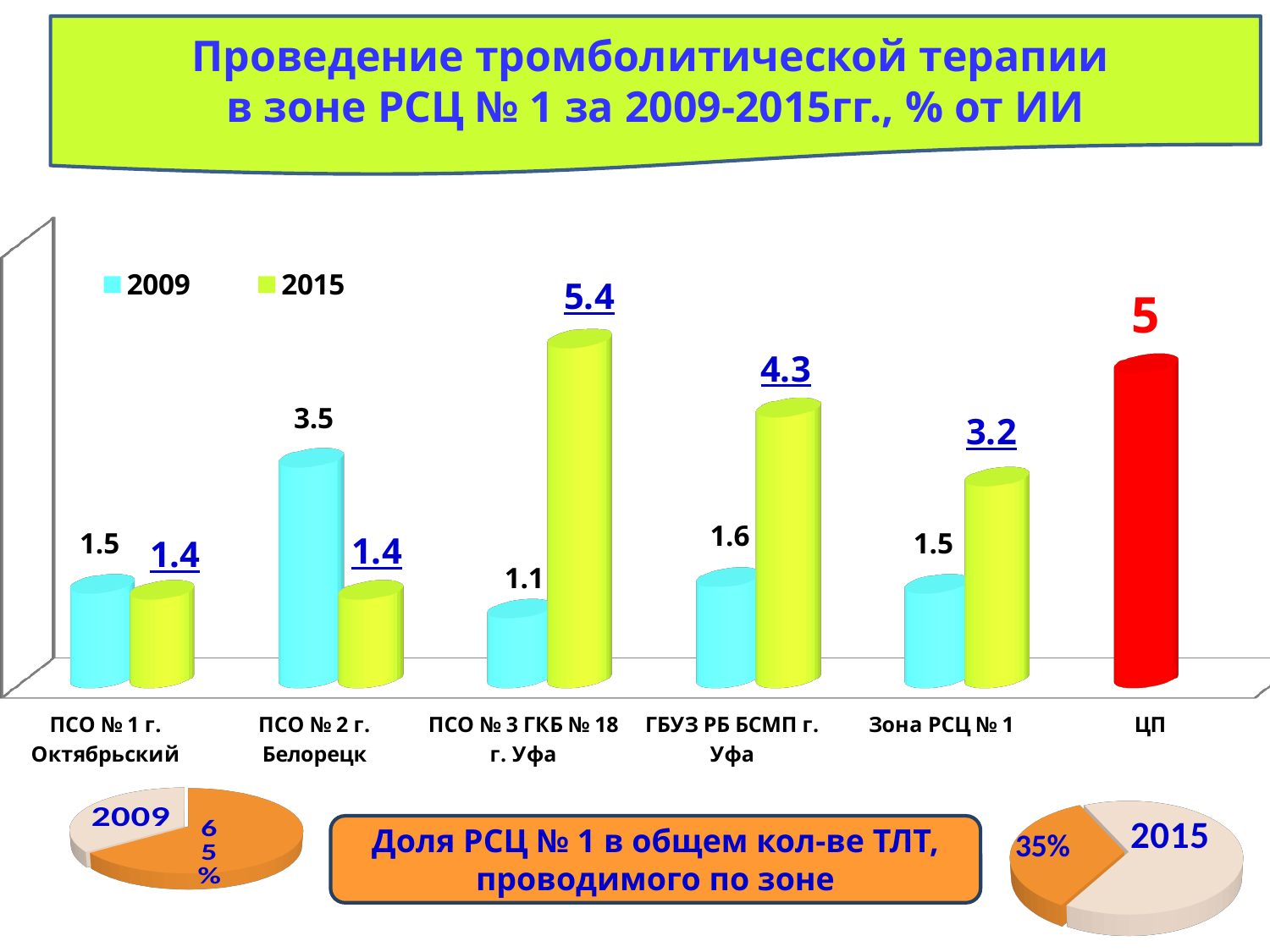
In the bar chart, what is the 2015 value for ПСО № 3 ГКБ № 18 г. Уфа? 5.4 In the pie chart labelled 2015 at the bottom right, what share is printed on the highlighted slice? 35% In the bar chart, which category has the highest 2015 value? ПСО № 3 ГКБ № 18 г. Уфа In the bar chart, what is the difference between the 2015 and 2009 values for ГБУЗ РБ БСМП г. Уфа? 2.7 In the pie chart labelled 2009 at the bottom left, what share is printed on the highlighted slice? 65% In the bar chart, what is the 2015 value for Зона РСЦ № 1? 3.2 What kind of chart is the main chart in the middle of the slide? bar chart In the bar chart, what is the 2009 value for ПСО № 2 г. Белорецк? 3.5 In the bar chart, which category has the lowest 2009 value? ПСО № 3 ГКБ № 18 г. Уфа How many series does the legend of the bar chart list? 2 In the bar chart, what is the value shown for ЦП? 5 In the bar chart, which is larger for ПСО № 2 г. Белорецк: the 2009 value or the 2015 value? 2009